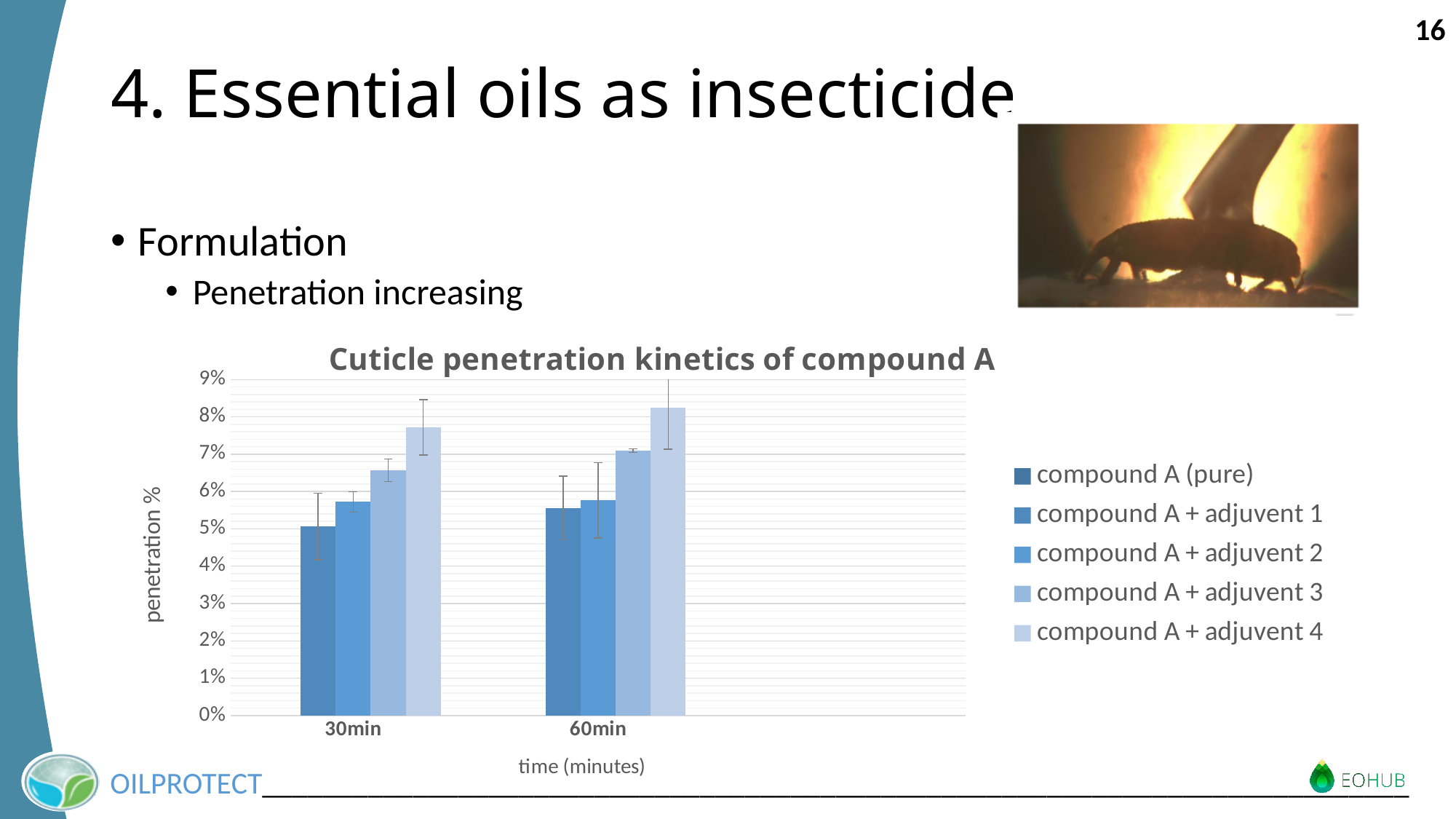
How many series does the chart legend list? 5 What is the title of the chart? Cuticle penetration kinetics of compound A Is the tallest bar at 60min greater or less than 8%? greater Which series has the lowest bar at 30min? compound A (pure) Is the tallest bar at 60min larger or smaller than the tallest bar at 30min? larger Is the value for compound A (pure) at 30min greater or less than 6%? less Is the tallest bar at 30min greater or less than 7%? greater How many time categories are shown on the x axis? 2 What kind of chart is shown on the slide? bar chart Which time category has the highest single bar? 60min Does the value for compound A (pure) rise or fall from 30min to 60min? rise What is the label of the y axis? penetration %